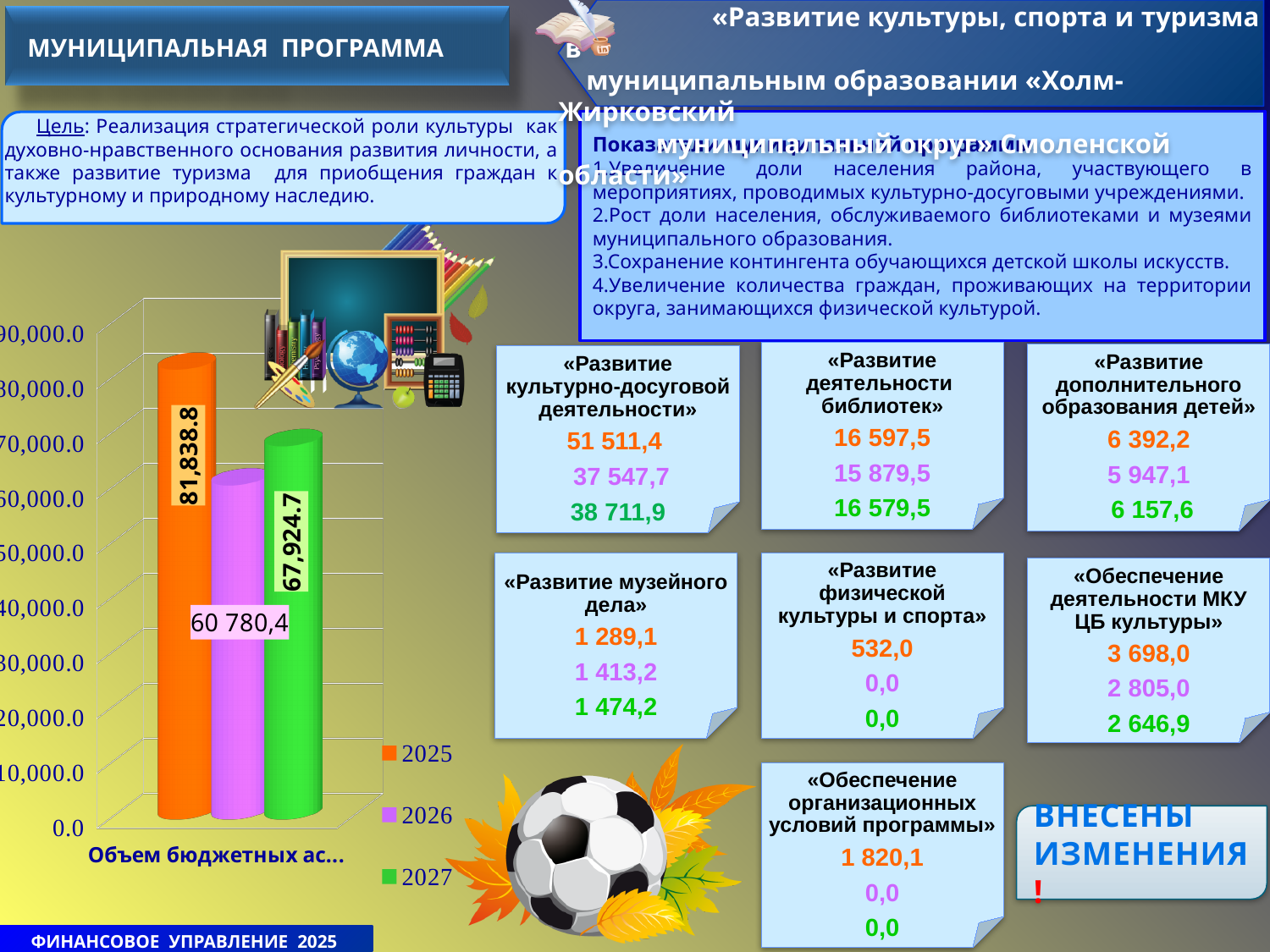
Which year has the highest bar in the chart? 2025 Is the value for 2025 in the chart greater or less than 80,000.0? greater What is the value of the 2026 bar in the chart? 60 780,4 What is the value of the 2025 bar in the chart? 81,838.8 Which year has the lowest bar in the chart? 2026 What is the difference between the 2025 value and the 2027 value in the chart? 13,914.1 Which is larger in the chart, the value for 2026 or the value for 2027? 2027 What is the value of the 2027 bar in the chart? 67,924.7 What colour is the bar for 2027 in the chart? green Is the value for 2026 in the chart greater or less than 70,000.0? less What type of chart is shown on the slide? bar chart How many series does the chart legend list? 3